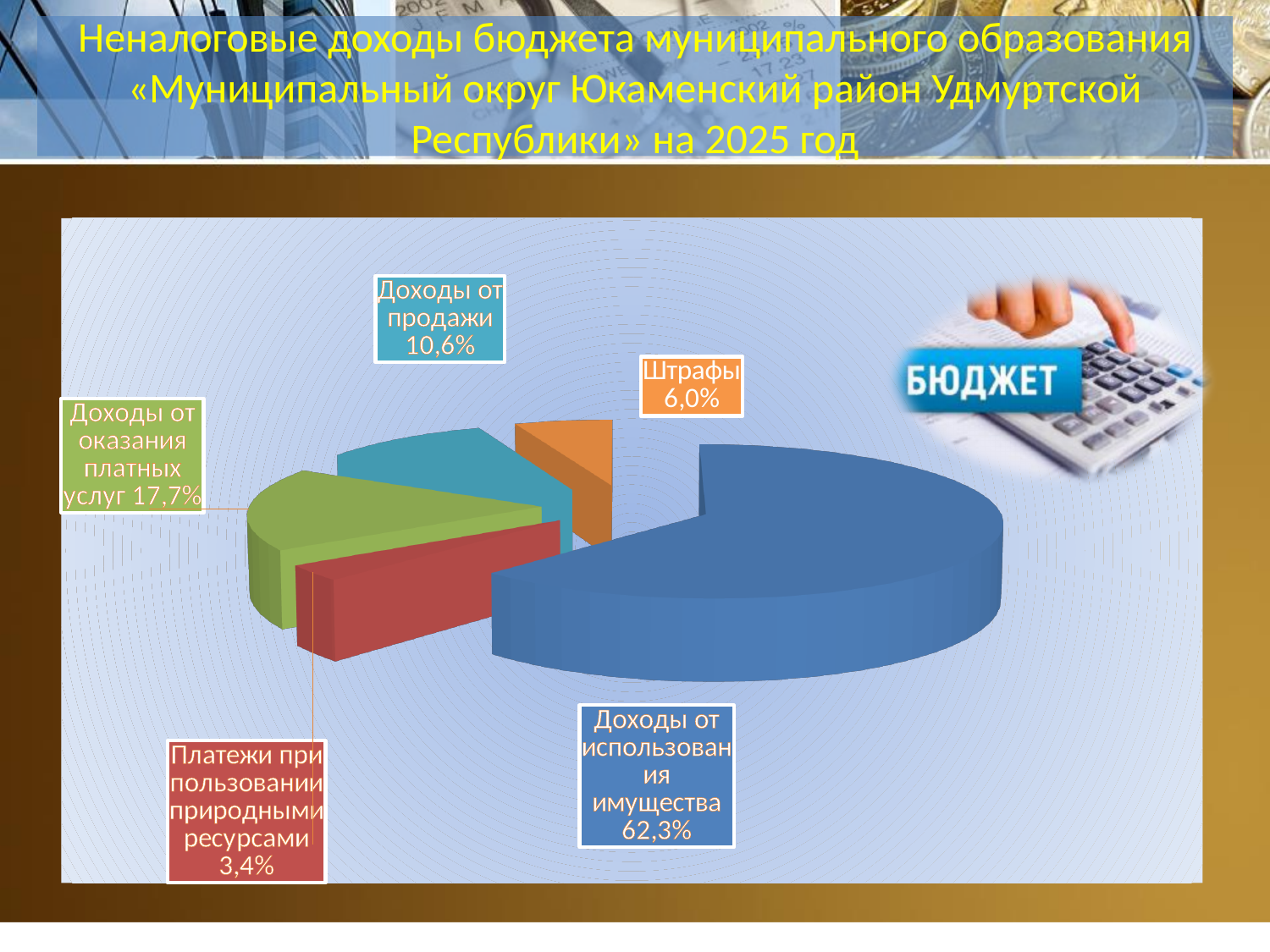
Which category has the largest share of the pie? Доходы от использования имущества What kind of chart is shown on the slide? Pie chart What share is shown for Платежи при пользовании природными ресурсами? 3,4% What is the difference in percentage points between Доходы от продажи and Штрафы? 4,6 How many categories (slices) does the pie chart show? 5 Which category has the smallest share of the pie? Платежи при пользовании природными ресурсами What share is shown for Доходы от оказания платных услуг? 17,7% What colour is the slice for Штрафы? Orange What share is shown for Штрафы? 6,0% What is the difference in percentage points between Доходы от использования имущества and Доходы от оказания платных услуг? 44,6 Which is larger: the share for Доходы от продажи or the share for Штрафы? Доходы от продажи What share of non-tax revenues comes from Доходы от использования имущества? 62,3%